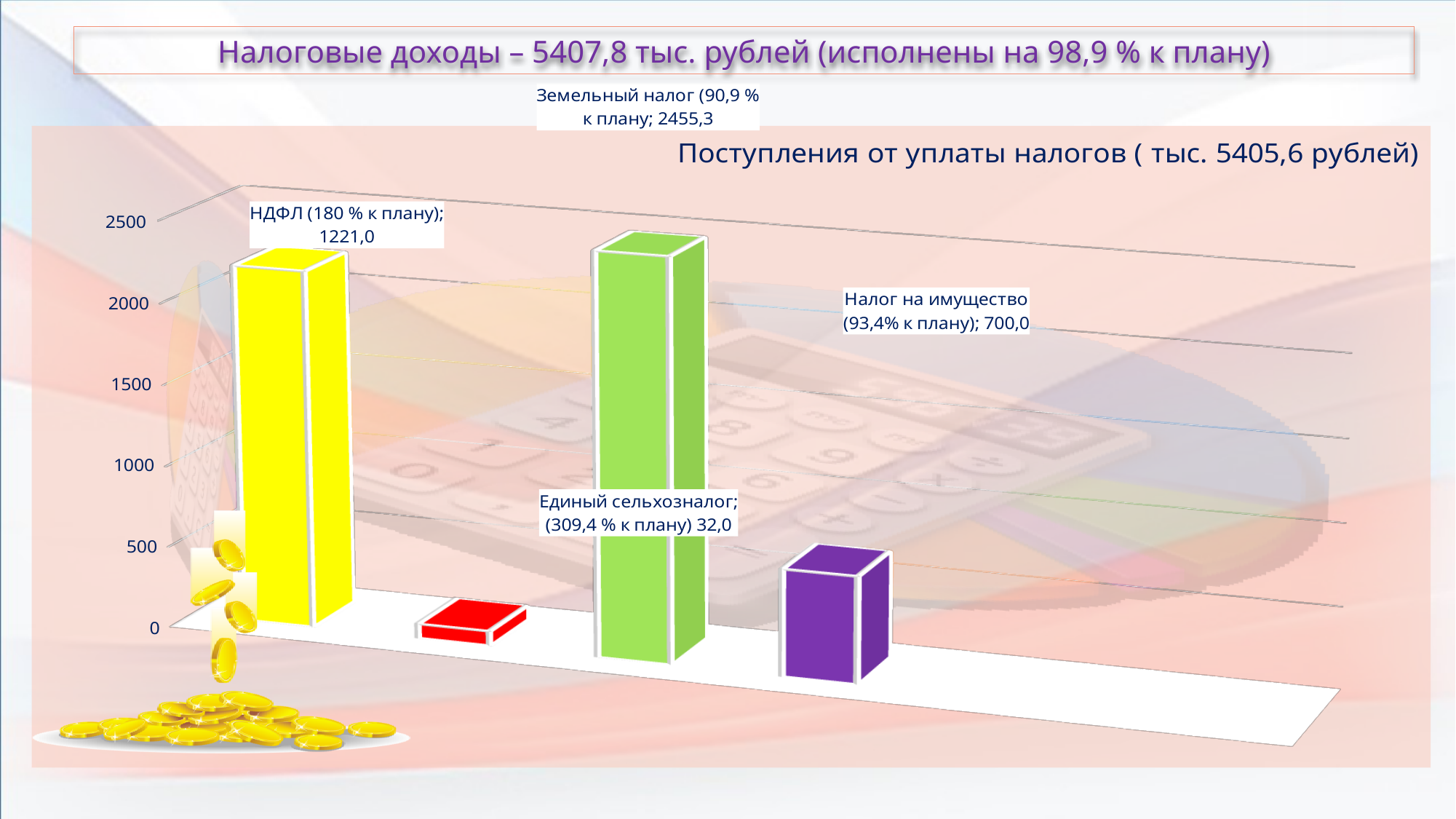
Which tax has the highest value on the chart? Земельный налог What is the difference between the values for Земельный налог and НДФЛ? 1234,3 What percentage of plan is shown for НДФЛ in its data label? 180 % Which tax has the lowest value on the chart? Единый сельхозналог What is the value shown for Единый сельхозналог? 32,0 What kind of chart is shown on the slide? bar chart Which is larger, the value for НДФЛ or the value for Налог на имущество? НДФЛ How many bars are shown on the chart? 4 What is the value shown for НДФЛ? 1221,0 What is the value shown for Налог на имущество? 700,0 Is the value for Налог на имущество greater or less than 1000? less What is the value shown for Земельный налог? 2455,3